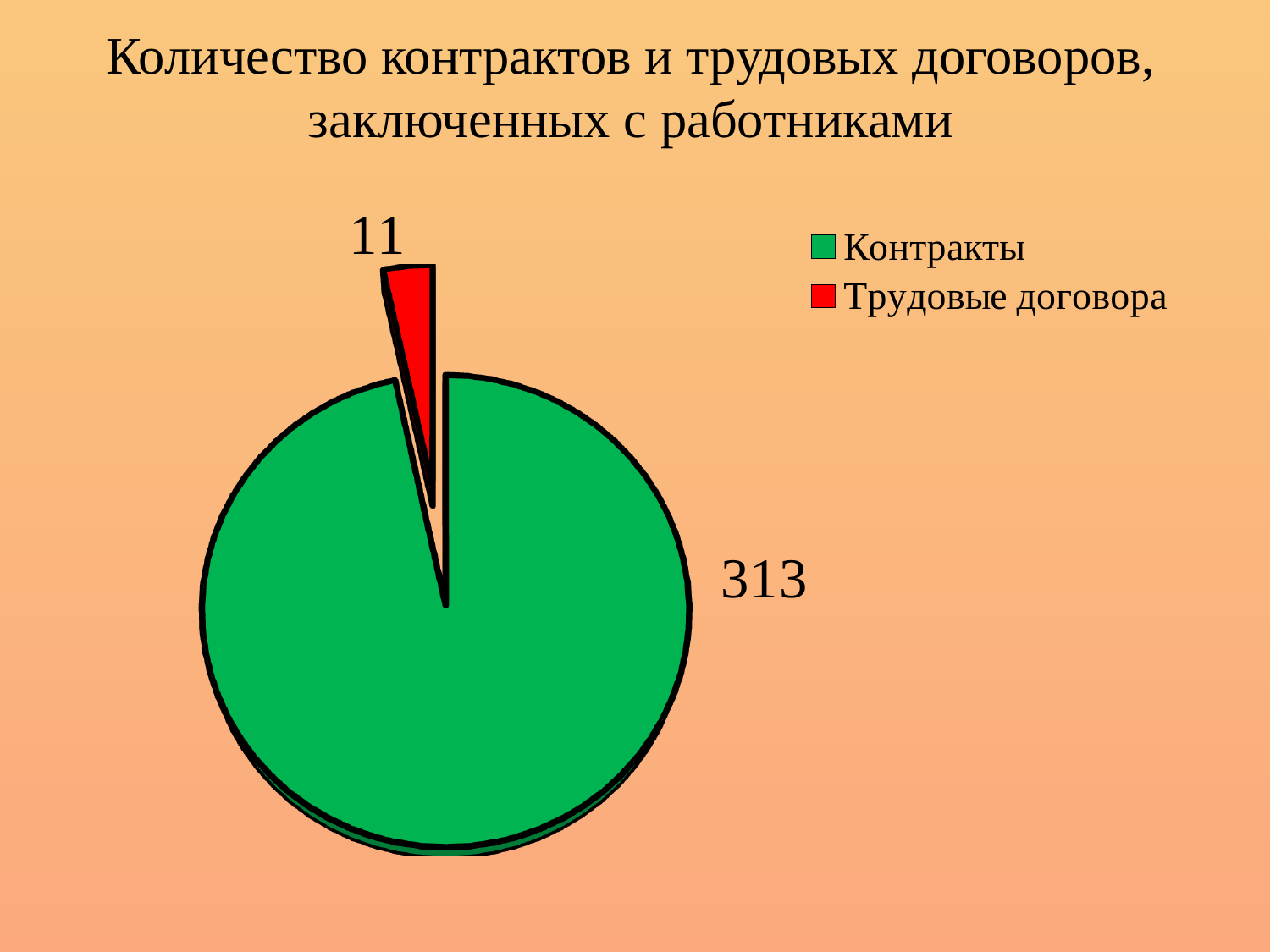
To the nearest whole percent, what share of the pie does Трудовые договора represent? 3% What is the total of the two values shown in the pie chart? 324 What colour is the slice for Трудовые договора? Red Which is larger: the value for Контракты or the value for Трудовые договора? Контракты What is the difference between the values for Контракты and Трудовые договора? 302 Which category has the largest slice in the pie chart? Контракты How many categories does the pie chart show? 2 What is the value for Трудовые договора in the pie chart? 11 What kind of chart is shown on the slide? Pie chart Which category has the smallest slice in the pie chart? Трудовые договора How many entries does the legend list? 2 What is the value for Контракты in the pie chart? 313